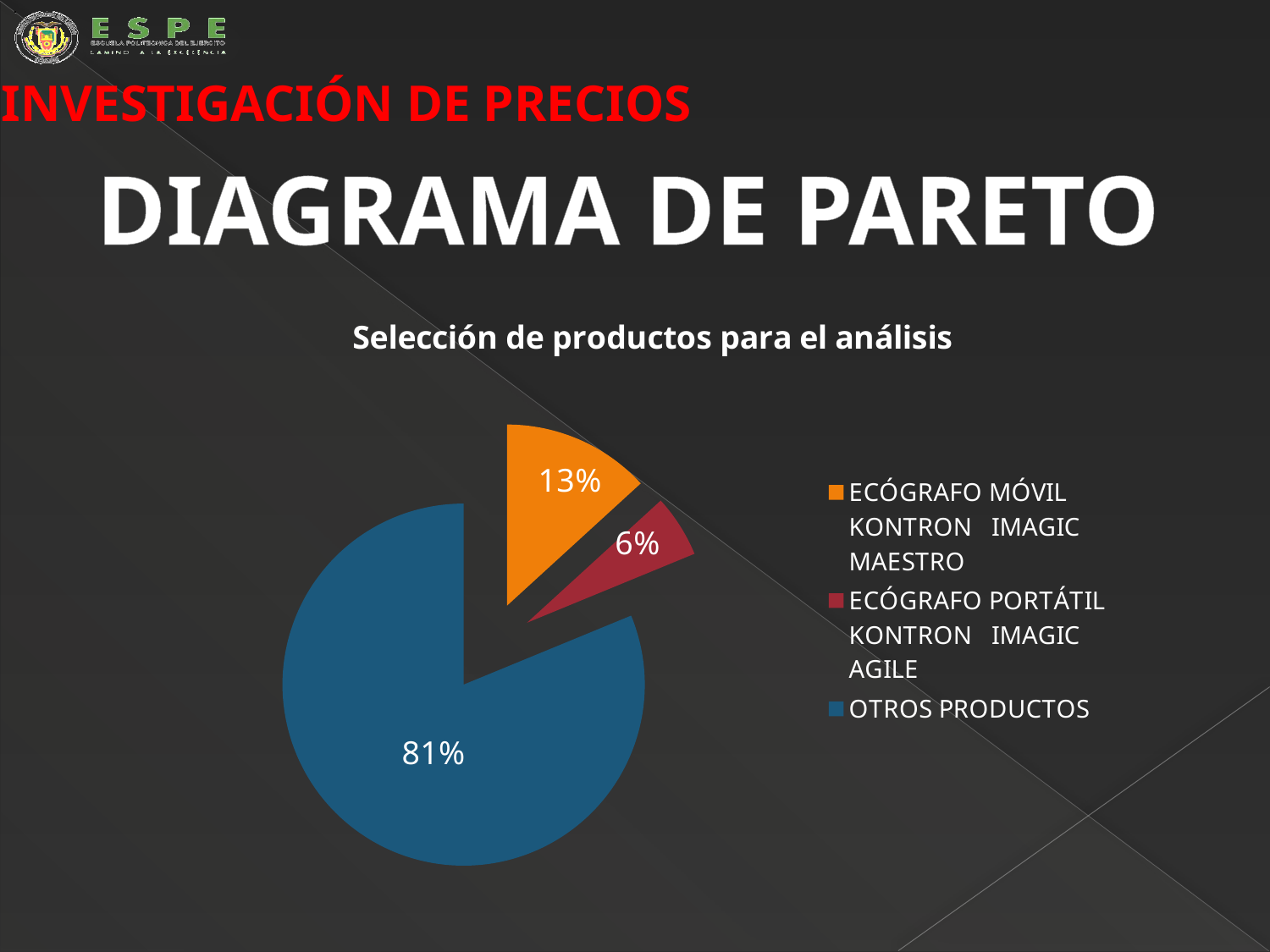
Which category has the smallest slice of the pie? ECÓGRAFO PORTÁTIL KONTRON IMAGIC AGILE What is the combined share of the two ECÓGRAFO slices? 19% What colour is the slice for OTROS PRODUCTOS? Blue What is the difference in percentage points between OTROS PRODUCTOS and ECÓGRAFO MÓVIL KONTRON IMAGIC MAESTRO? 68 percentage points What share of the pie does OTROS PRODUCTOS represent? 81% What is the title of the chart? Selección de productos para el análisis Which is larger, the slice for ECÓGRAFO MÓVIL KONTRON IMAGIC MAESTRO or the slice for ECÓGRAFO PORTÁTIL KONTRON IMAGIC AGILE? ECÓGRAFO MÓVIL KONTRON IMAGIC MAESTRO Which category has the largest slice of the pie? OTROS PRODUCTOS What share of the pie does ECÓGRAFO PORTÁTIL KONTRON IMAGIC AGILE represent? 6% What share of the pie does ECÓGRAFO MÓVIL KONTRON IMAGIC MAESTRO represent? 13% What kind of chart is shown on the slide? Pie chart How many categories does the pie chart show? 3